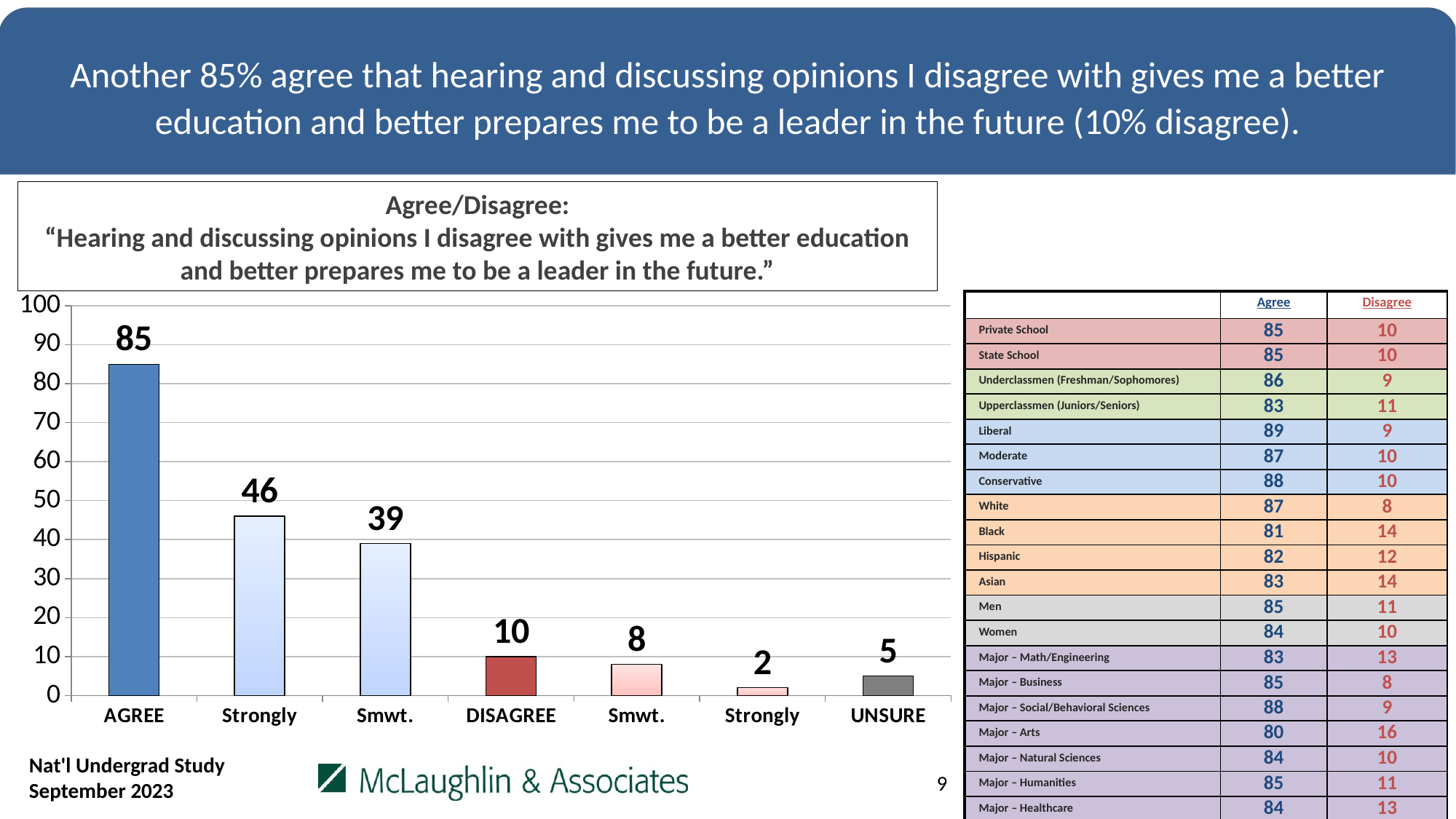
What is the value for DISAGREE in the bar chart? 10 How many bars are shown in the bar chart? 7 What is the value for AGREE in the bar chart? 85 What is the value for UNSURE in the bar chart? 5 What is the difference between the AGREE and DISAGREE values? 75 Which is larger, the Smwt. agree value or the Smwt. disagree value? Smwt. agree Which category has the highest value in the bar chart? AGREE Which category has the lowest value in the bar chart? Strongly (disagree) What is the maximum value shown on the vertical axis of the bar chart? 100 What is the value for the Strongly bar under DISAGREE? 2 What is the difference between the Strongly agree and Smwt. agree values? 7 What kind of chart is shown on the slide? Bar chart